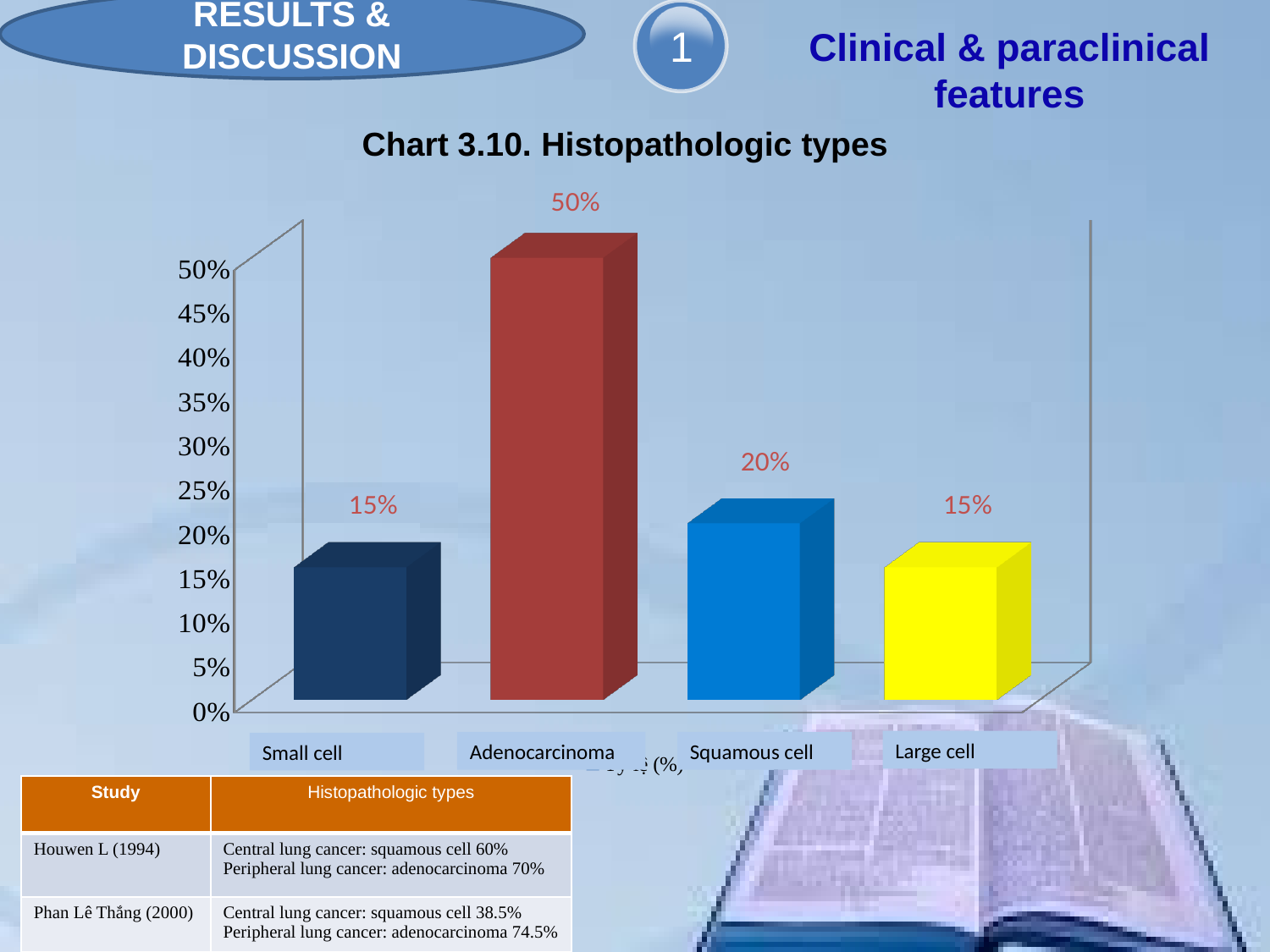
What is the value for Squamous cell? 20% What is the title of the chart? Chart 3.10. Histopathologic types What is the difference between the values for Adenocarcinoma and Squamous cell? 30% How many histopathologic types are shown in the chart? 4 What kind of chart is shown on the slide? bar chart What is the value for Small cell? 15% Is the value for Adenocarcinoma greater or less than 40%? greater Which histopathologic type has the highest value? Adenocarcinoma Which is larger, the value for Squamous cell or the value for Small cell? Squamous cell What is the difference between the values for Squamous cell and Large cell? 5% What is the value for Adenocarcinoma? 50% What is the value for Large cell? 15%